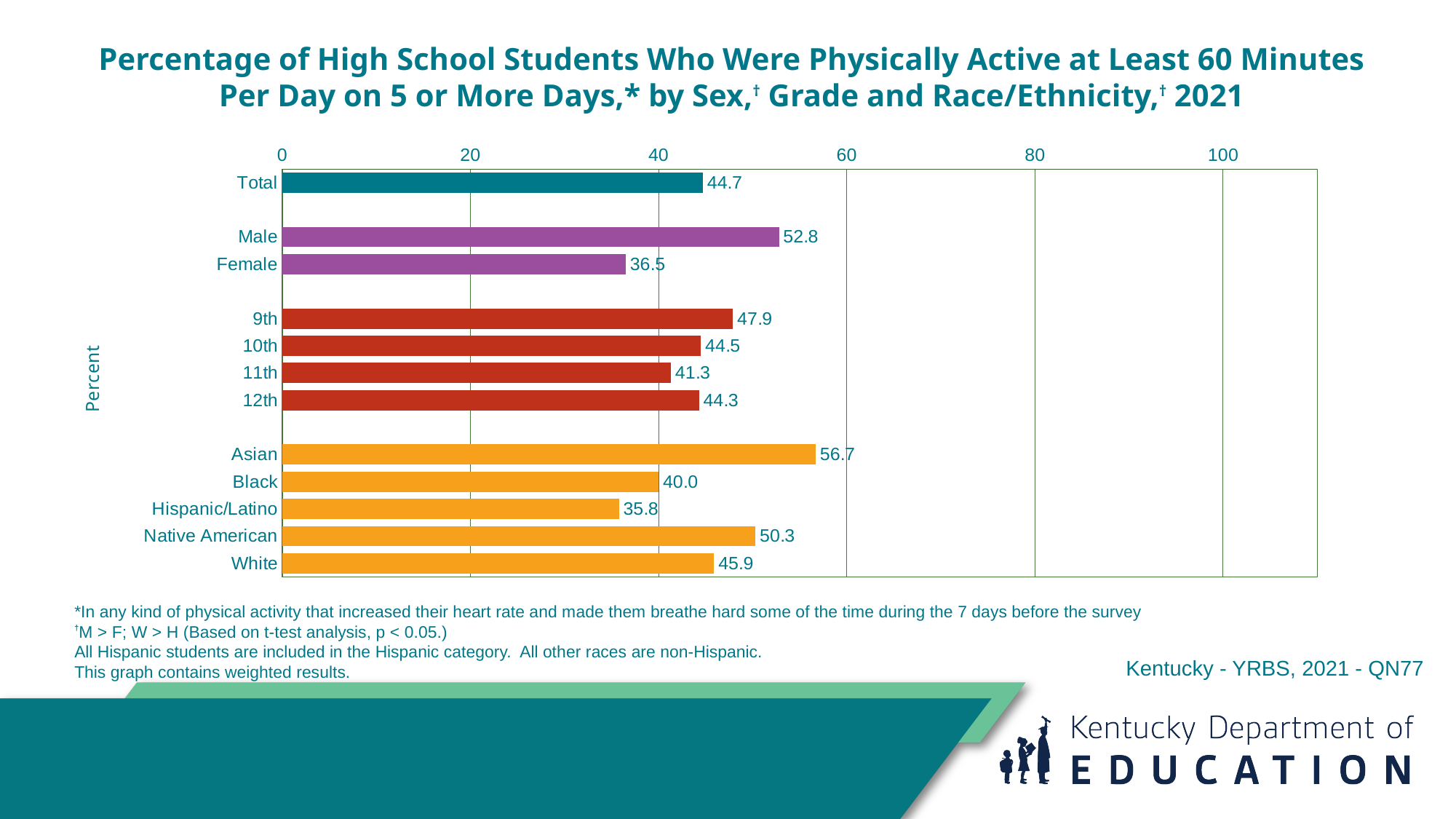
What is the value for Total? 44.7 What is the value for Female? 36.5 Among the grade categories (9th to 12th), which has the lowest value? 11th What kind of chart is shown? bar chart What is the value for Native American? 50.3 What is the difference between the Male and Female values? 16.3 Which category has the lowest value? Hispanic/Latino Which is larger, the value for 9th or the value for 11th? 9th Is the value for Black greater or less than 60? less What is the label on the vertical axis? Percent How many categories are plotted on the chart? 13 Which category has the highest value? Asian